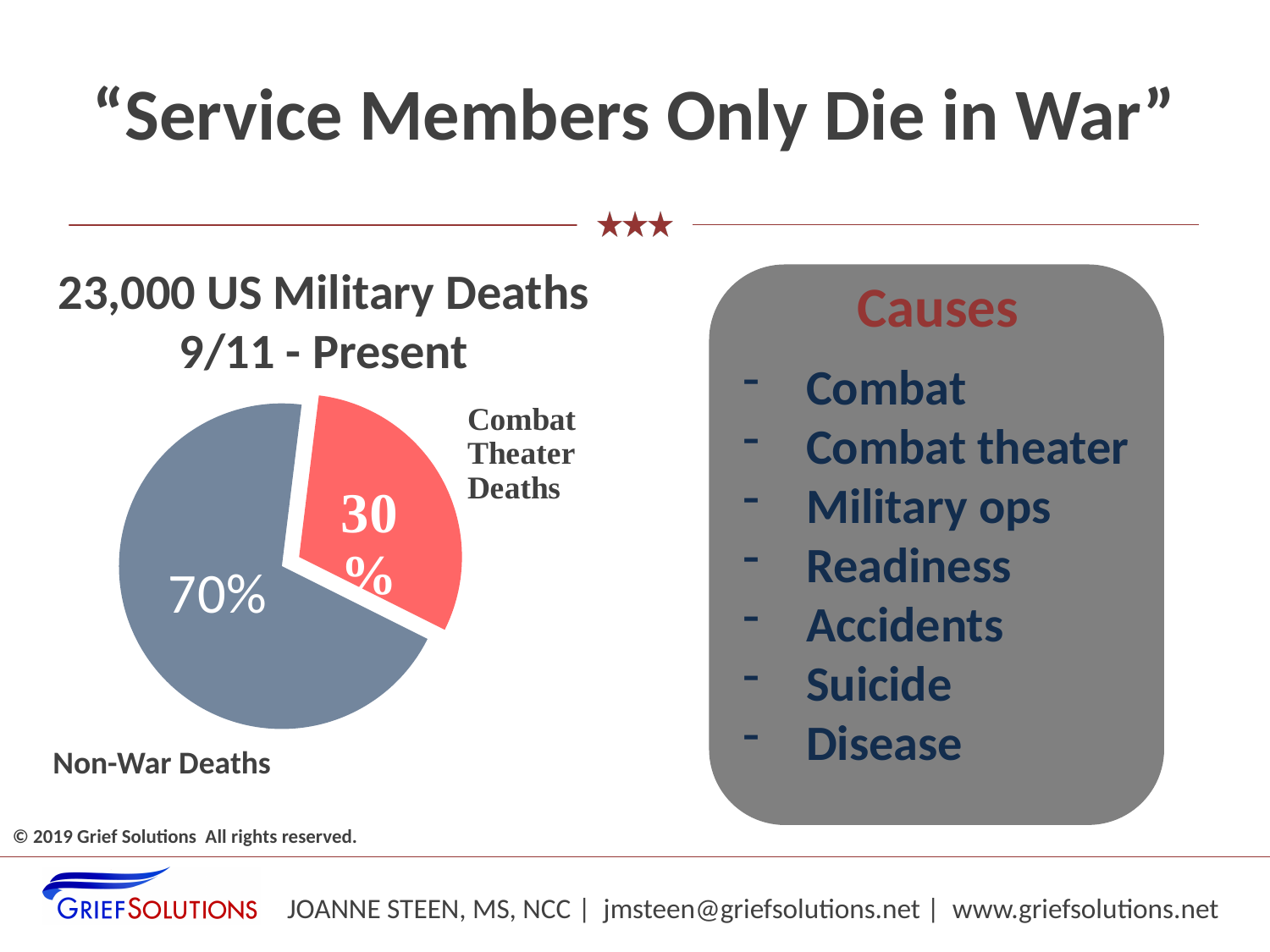
What colour is the Combat Theater Deaths slice of the pie chart? red What percentage of the pie chart is labelled Non-War Deaths? 70% What is the difference in percentage points between the Non-War Deaths slice and the Combat Theater Deaths slice? 40 Which slice of the pie chart is the largest? Non-War Deaths Which slice of the pie chart is larger, Non-War Deaths or Combat Theater Deaths? Non-War Deaths What percentage of the pie chart is labelled Combat Theater Deaths? 30% Which slice of the pie chart is the smallest? Combat Theater Deaths How many slices does the pie chart have? 2 What share of the pie does the Combat Theater Deaths slice represent? 30% What is the title of the pie chart? 23,000 US Military Deaths 9/11 - Present What kind of chart is shown on the slide? pie chart